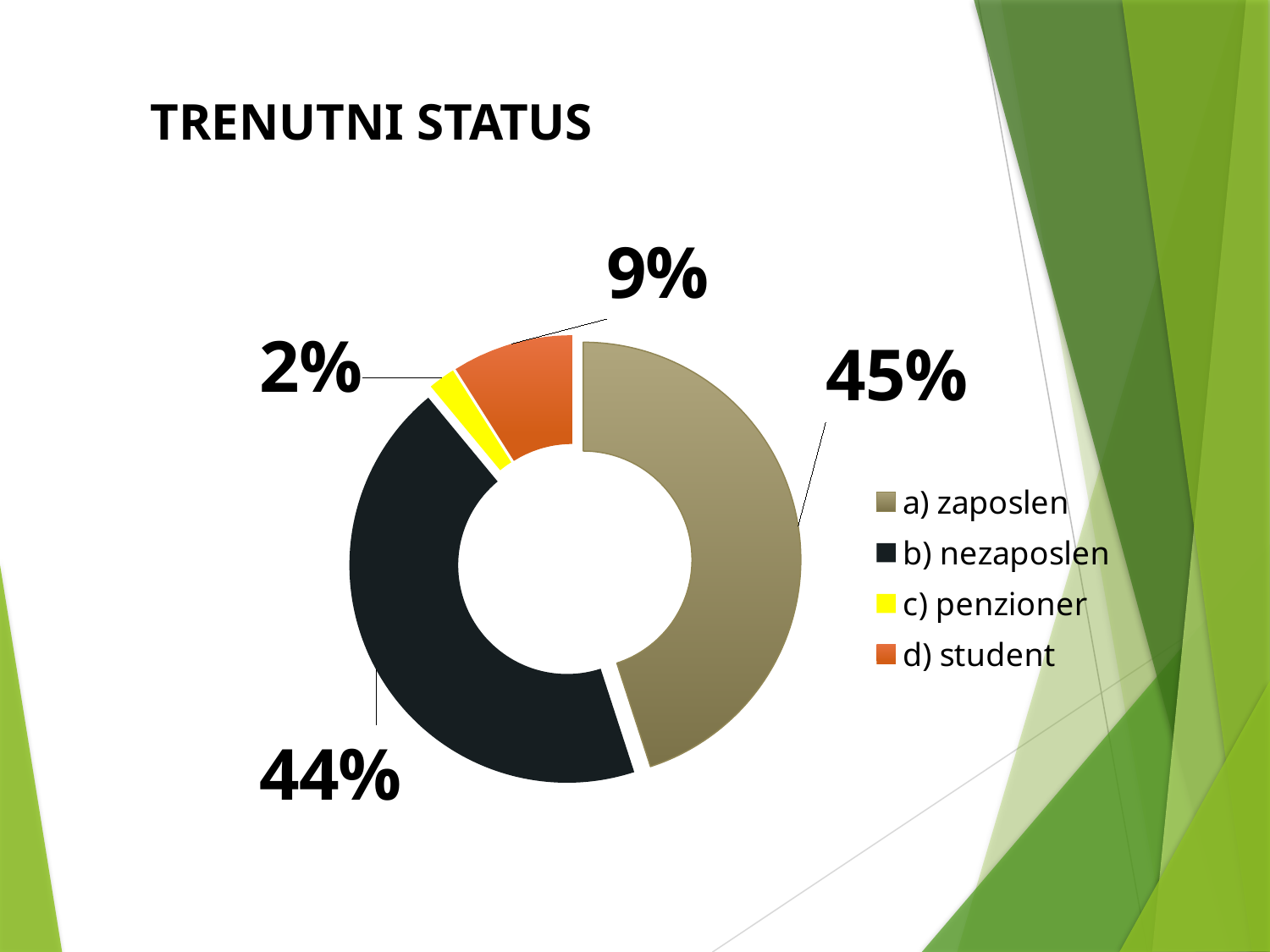
Which category has the smallest share of the chart? c) penzioner How many categories does the chart show? 4 What percentage of the chart is a) zaposlen? 45% Which is larger, the share for d) student or the share for c) penzioner? d) student What is the title of the slide? TRENUTNI STATUS What colour is the segment for c) penzioner? Yellow What is the difference in percentage points between d) student and c) penzioner? 7 What percentage of the chart is b) nezaposlen? 44% Which category has the largest share of the chart? a) zaposlen What kind of chart is shown on the slide? Doughnut chart What percentage of the chart is d) student? 9% What percentage of the chart is c) penzioner? 2%